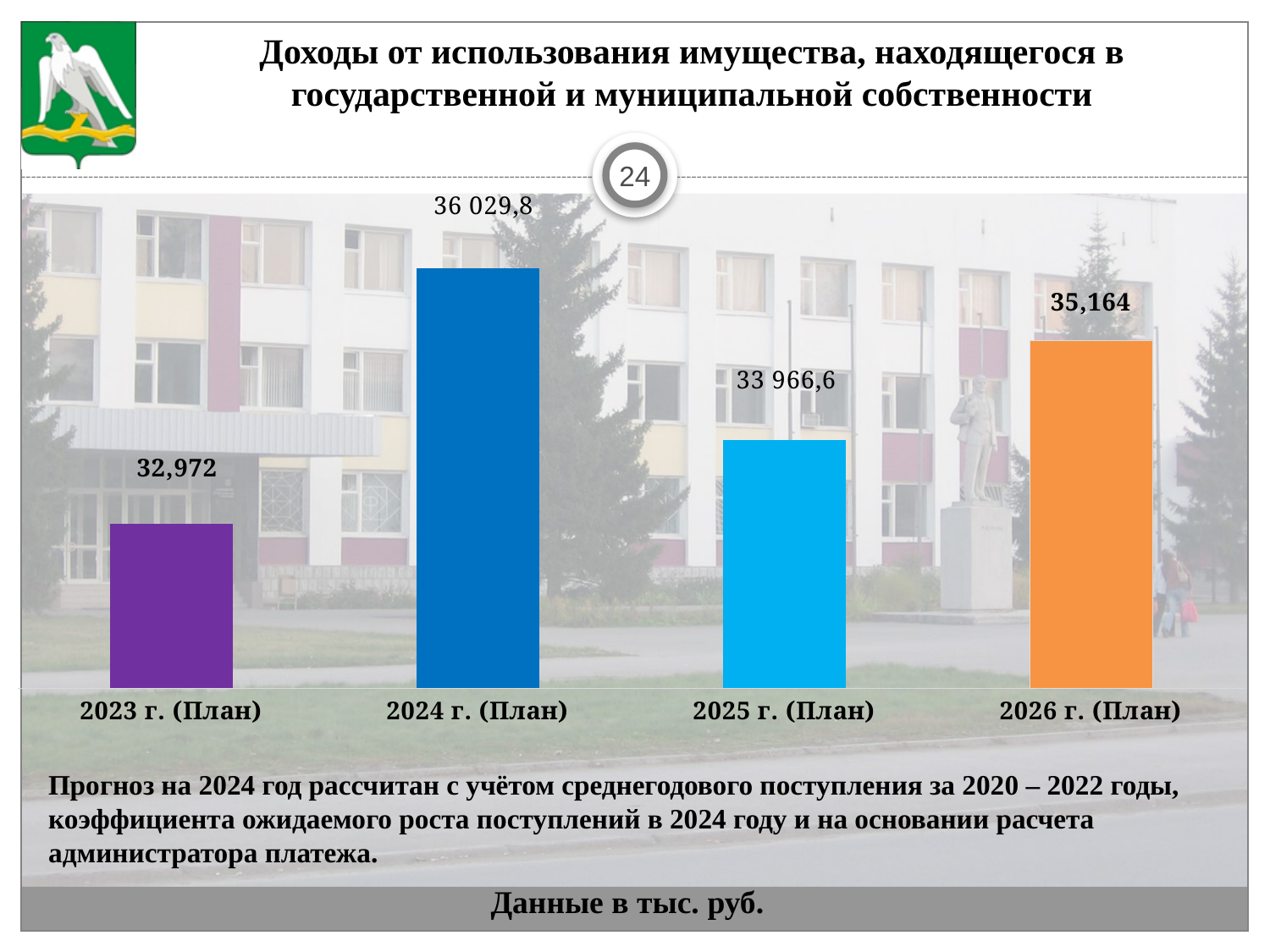
What is the value for 2023 г. (План)? 32,972 Which is larger, the value for 2025 г. (План) or 2026 г. (План)? 2026 г. (План) Which year has the highest value? 2024 г. (План) What is the value for 2025 г. (План)? 33 966,6 What kind of chart is shown on the slide? Bar chart Does the value rise or fall from 2023 г. (План) to 2024 г. (План)? Rise Which year has the lowest value? 2023 г. (План) How many bars are shown in the chart? 4 In what units are the data on the chart given? тыс. руб. What is the value for 2024 г. (План)? 36 029,8 What is the difference between the values for 2024 г. (План) and 2025 г. (План)? 2 063,2 What is the value for 2026 г. (План)? 35,164